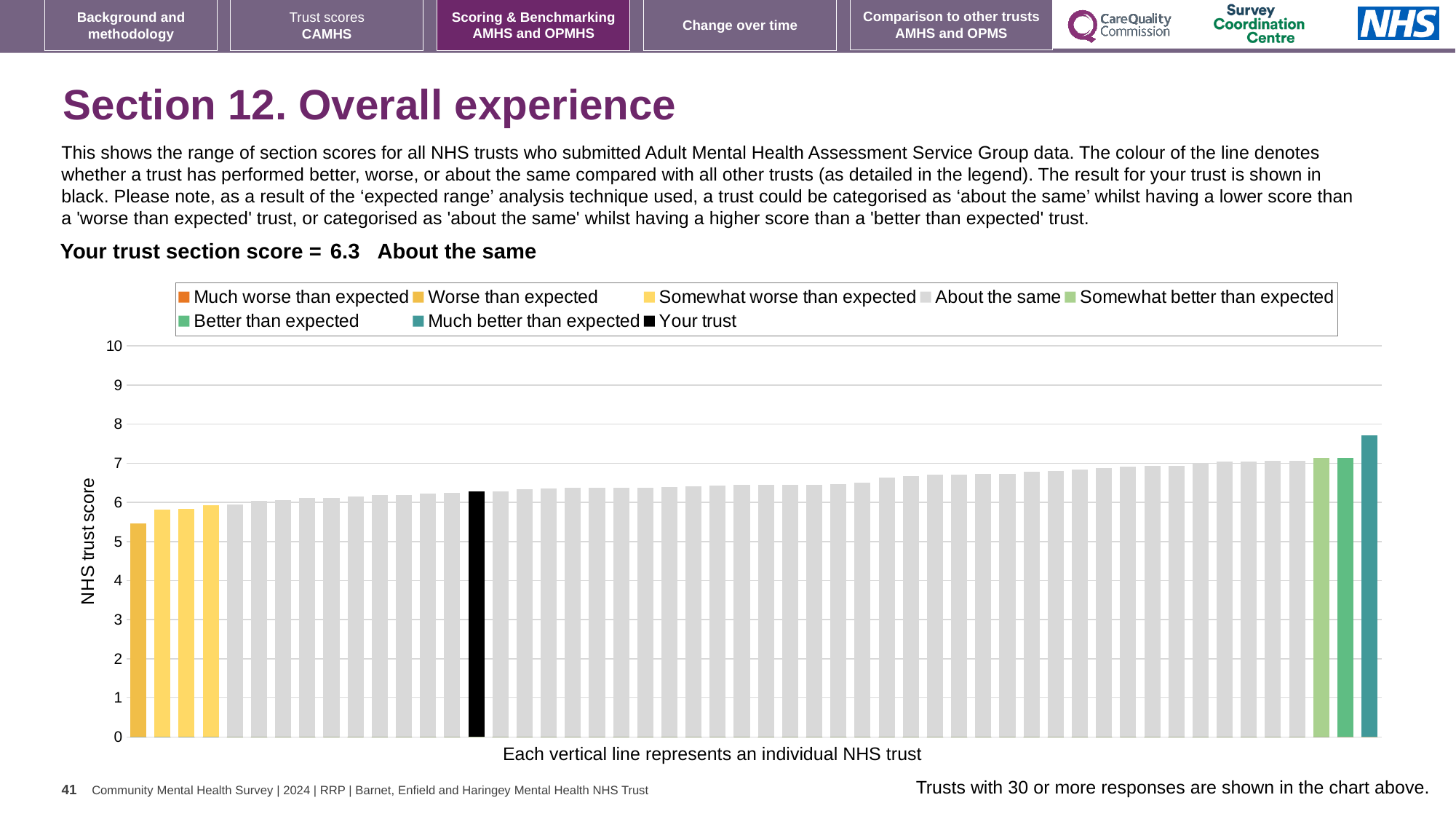
Is the value of the shortest bar on the chart greater or less than 6? less Is the value of the shortest bar on the chart greater or less than 5? greater Which benchmarking category is your trust placed in for this section? About the same Is the value of the black 'Your trust' bar greater or less than 7? less How many entries does the chart legend list? 8 What is the section score for your trust shown above the chart? 6.3 Do the bar values rise or fall from left to right across the chart? rise Which legend category does the tallest bar on the chart belong to? Much better than expected What kind of chart is shown on the slide? bar chart What is the label on the vertical axis of the chart? NHS trust score How many bars are coloured teal (Much better than expected)? 1